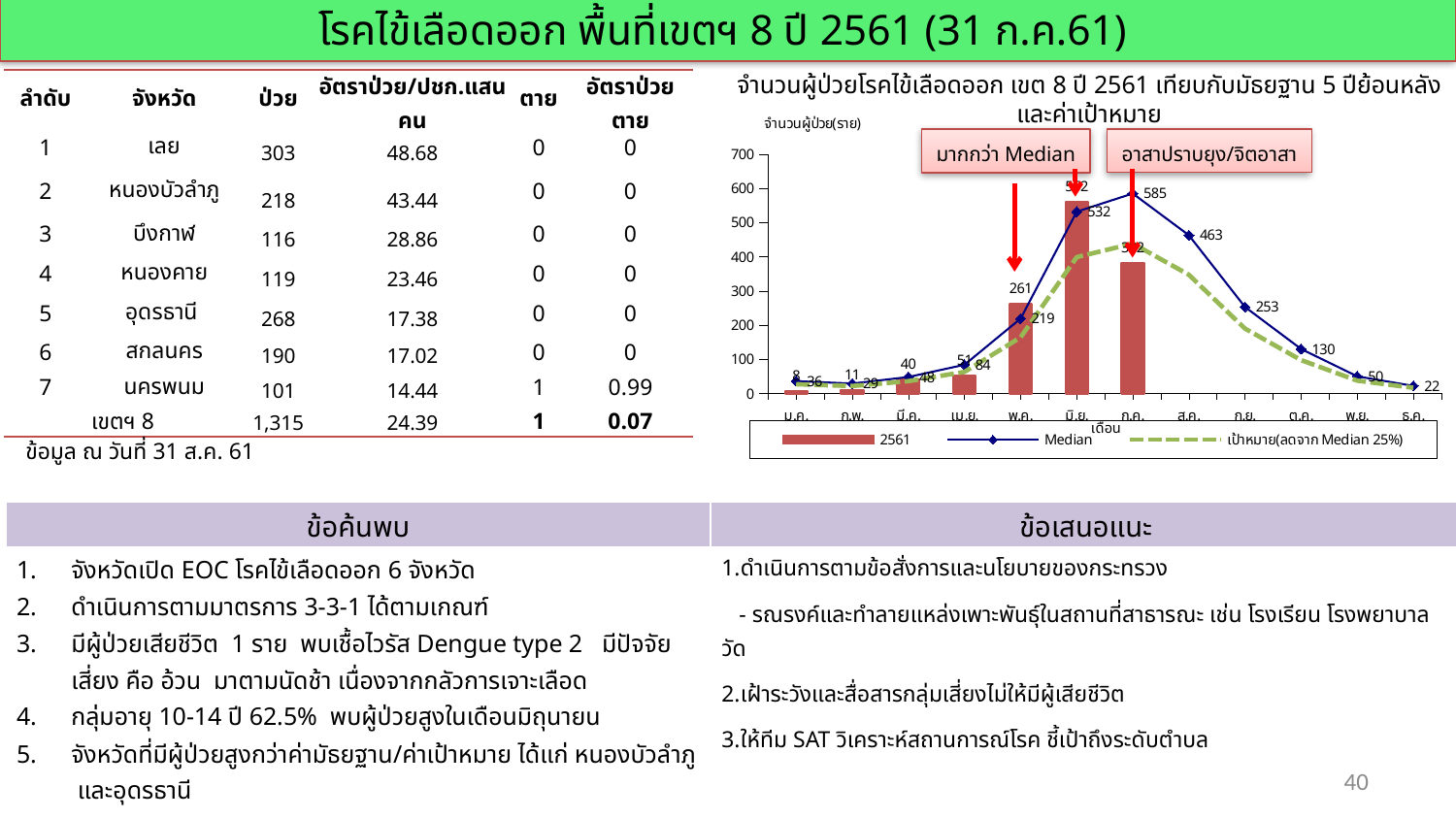
What is the difference between the Median values for ก.ค. and ส.ค.? 122 What kind of chart is shown on the right side of the slide? A combination bar and line chart In which month is the Median line at its highest? ก.ค. For พ.ค., which is larger: the 2561 value or the Median value? 2561 What is the Median value for ต.ค. in the chart? 130 What is the 2561 value for พ.ค. in the chart? 261 In which month is the Median line at its lowest? ธ.ค. Does the Median line rise or fall from ก.ค. to ธ.ค.? Falls What is the Median value for ก.ค. in the chart? 585 How many months are shown along the x axis of the chart? 12 Is the 2561 value for มิ.ย. greater or less than 500? greater How many series does the chart legend list? 3